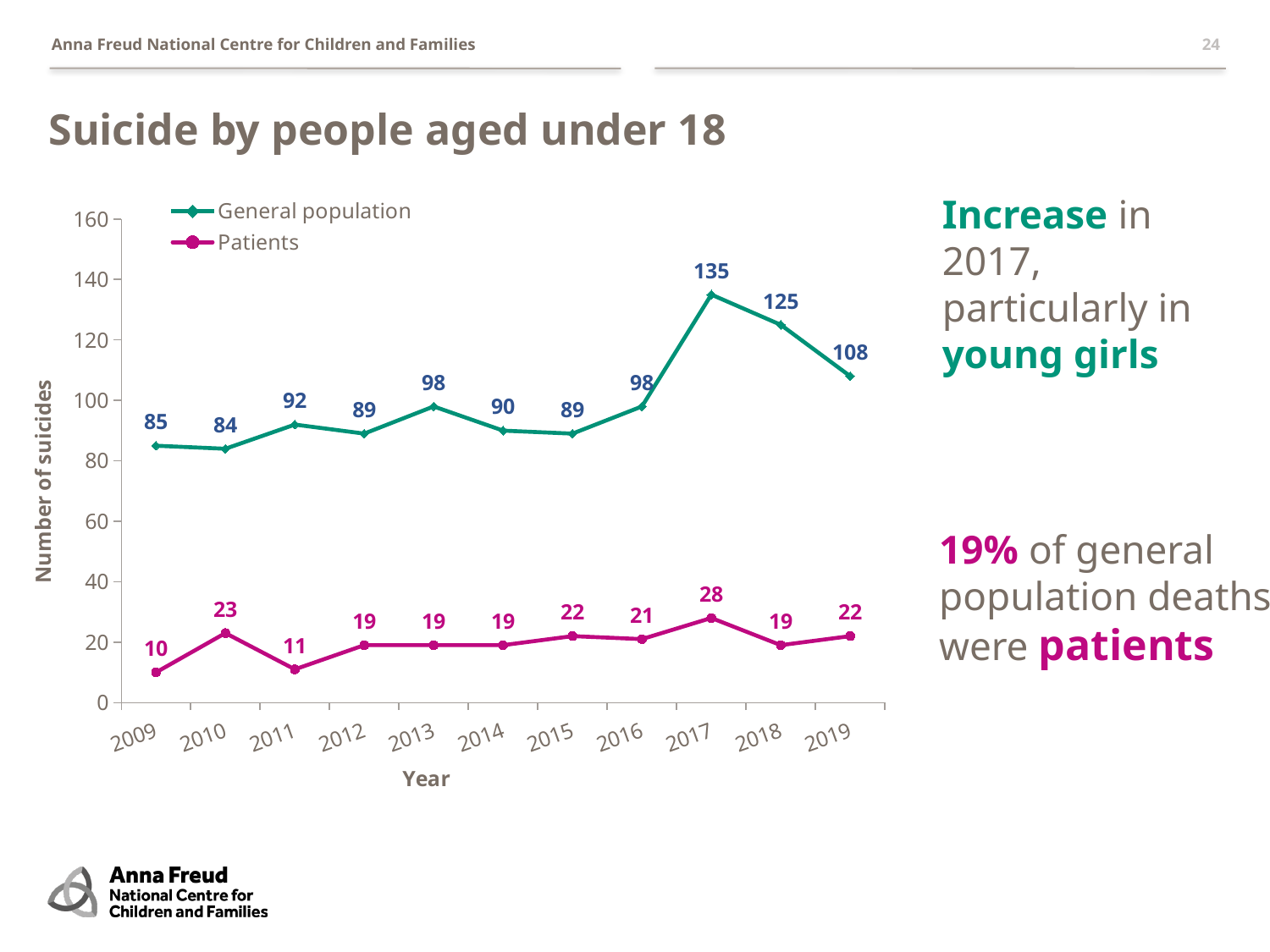
What is the difference between the General population values in 2017 and 2016? 37 What type of chart is shown on the slide? Line chart In which year is the General population value highest? 2017 What is the title of the chart? Suicide by people aged under 18 In which year is the Patients value lowest? 2009 What is the value for General population in 2017? 135 How many years are plotted on the x axis? 11 How many series does the legend list? 2 What is the value for Patients in 2009? 10 Is the General population value for 2018 greater or less than 120? greater Which is larger, the Patients value in 2010 or in 2011? 2010 Does the General population series rise or fall from 2017 to 2019? Fall